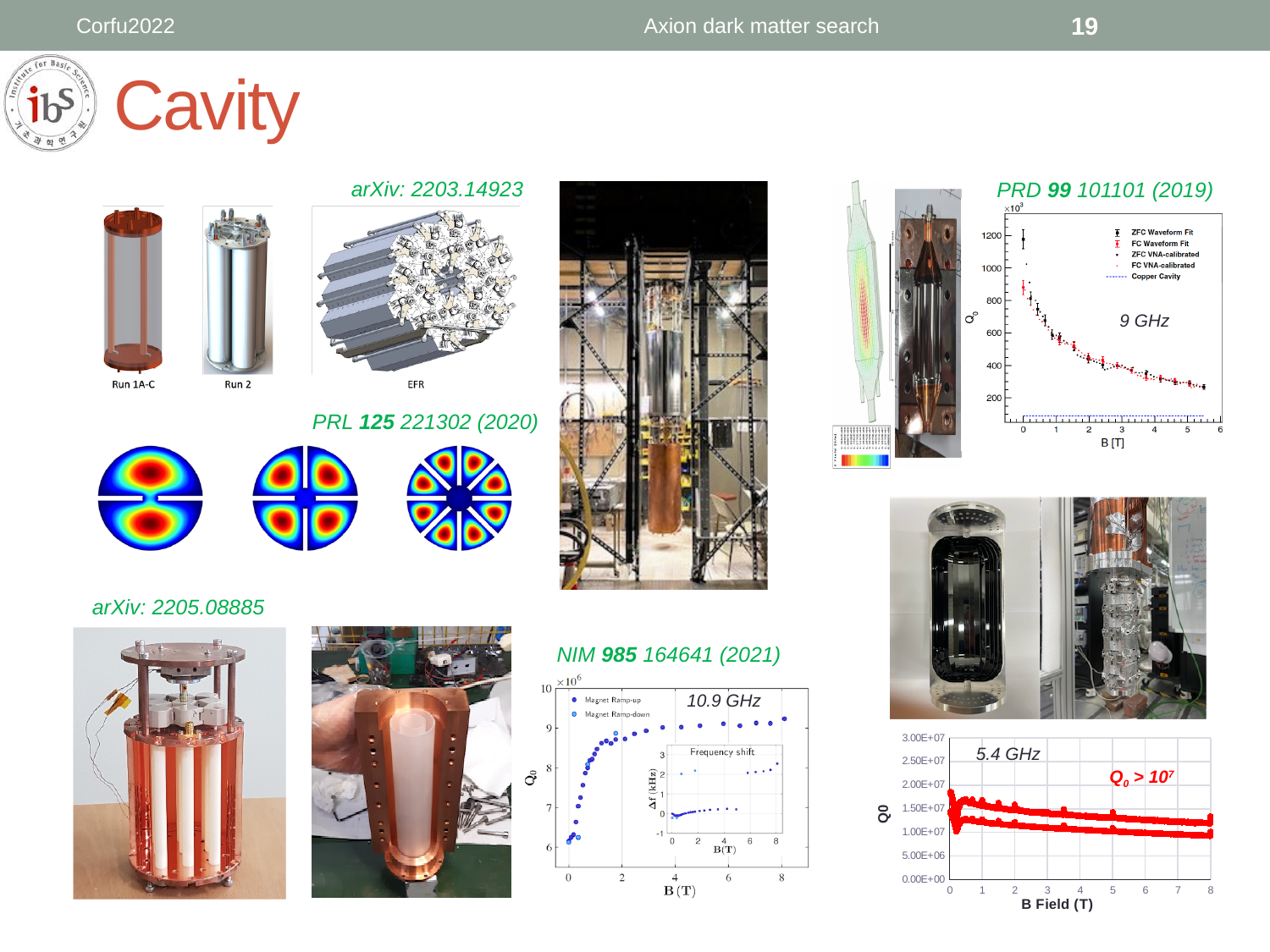
In the 9 GHz chart (top right), which legend entry is drawn as a dashed line? Copper Cavity In the 5.4 GHz chart (bottom right), does Q0 rise or fall as B Field (T) increases? fall In the 10.9 GHz chart (NIM 985 164641), is the Q0 value at B = 0 T greater or less than 7 (×10^6)? less In the 10.9 GHz chart (NIM 985 164641), does Q0 rise or fall as B (T) increases? rise In the 9 GHz chart (top right), does Q0 rise or fall as B [T] increases? fall In the 10.9 GHz chart (NIM 985 164641), how many series does the legend list? 2 In the 10.9 GHz chart (NIM 985 164641), what is the title of the inset plot? Frequency shift In the 10.9 GHz chart (NIM 985 164641), is the Q0 value at B = 8 T greater or less than 9 (×10^6)? greater In the 5.4 GHz chart (bottom right), is the Q0 value at B Field = 8 T greater or less than 1.50E+07? less In the 5.4 GHz chart (bottom right), what is the label of the x axis? B Field (T) In the 9 GHz chart (top right, PRD 99 101101), how many entries does the legend list? 5